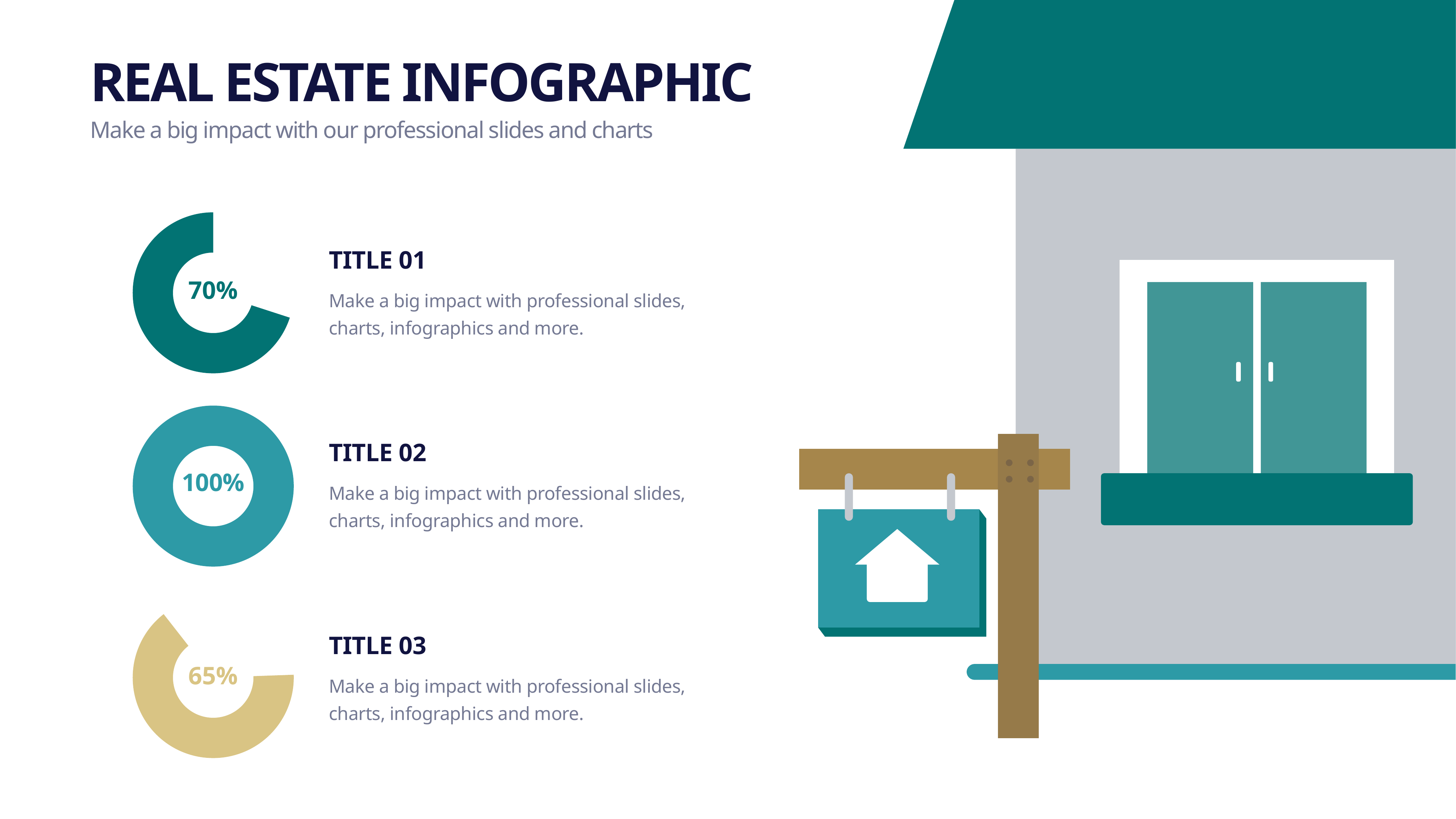
Which title has the lowest percentage in its donut chart? Title 03 What percentage is shown in the donut chart next to Title 03? 65% What percentage is shown in the donut chart next to Title 01? 70% What is the title of the slide? REAL ESTATE INFOGRAPHIC What is the difference between the percentages shown for Title 02 and Title 01? 30% Which title has the highest percentage in its donut chart? Title 02 What colour is the donut chart showing 65%? Gold Which is larger, the percentage for Title 01 or the percentage for Title 03? Title 01 What kind of chart is used to show the percentages on the slide? Donut chart What percentage is shown in the donut chart next to Title 02? 100% How many donut charts are shown on the slide? 3 What is the difference between the percentages shown for Title 01 and Title 03? 5%